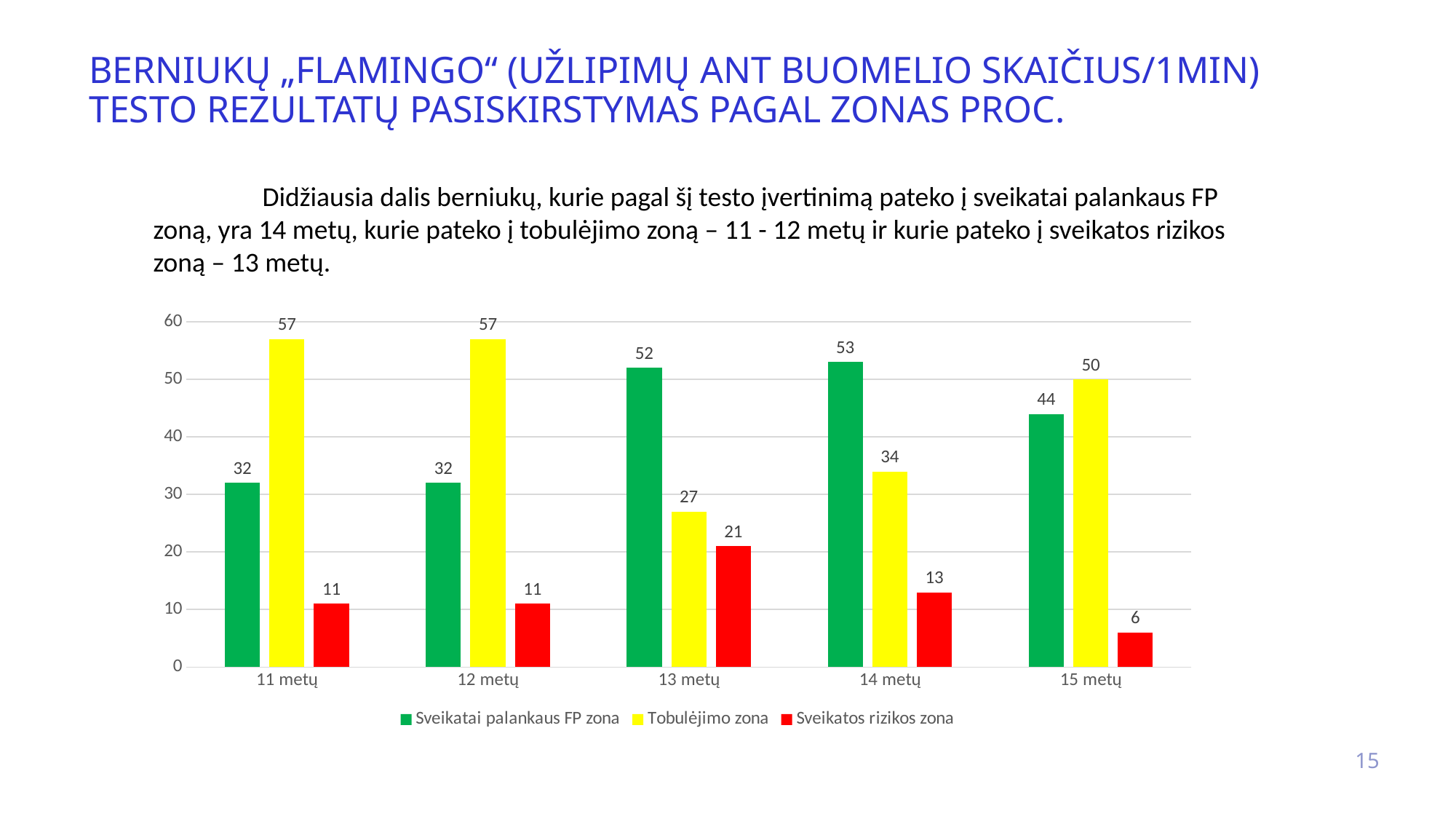
What colour represents Tobulėjimo zona in the chart? Yellow How many age groups are shown on the x axis? 5 What kind of chart is shown on the slide? Bar chart How many series does the legend list? 3 What is the difference between the Tobulėjimo zona value and the Sveikatai palankaus FP zona value for 11 metų? 25 Which age group has the highest value for Sveikatos rizikos zona? 13 metų What is the value of Sveikatos rizikos zona for 15 metų? 6 What is the value of Tobulėjimo zona for 13 metų? 27 Does the Sveikatos rizikos zona value rise or fall from 13 metų to 15 metų? Fall Which age group has the lowest value for Sveikatai palankaus FP zona? 11 metų and 12 metų (both 32) What is the value of Sveikatai palankaus FP zona for 14 metų? 53 For 15 metų, which is larger: Sveikatai palankaus FP zona or Tobulėjimo zona? Tobulėjimo zona